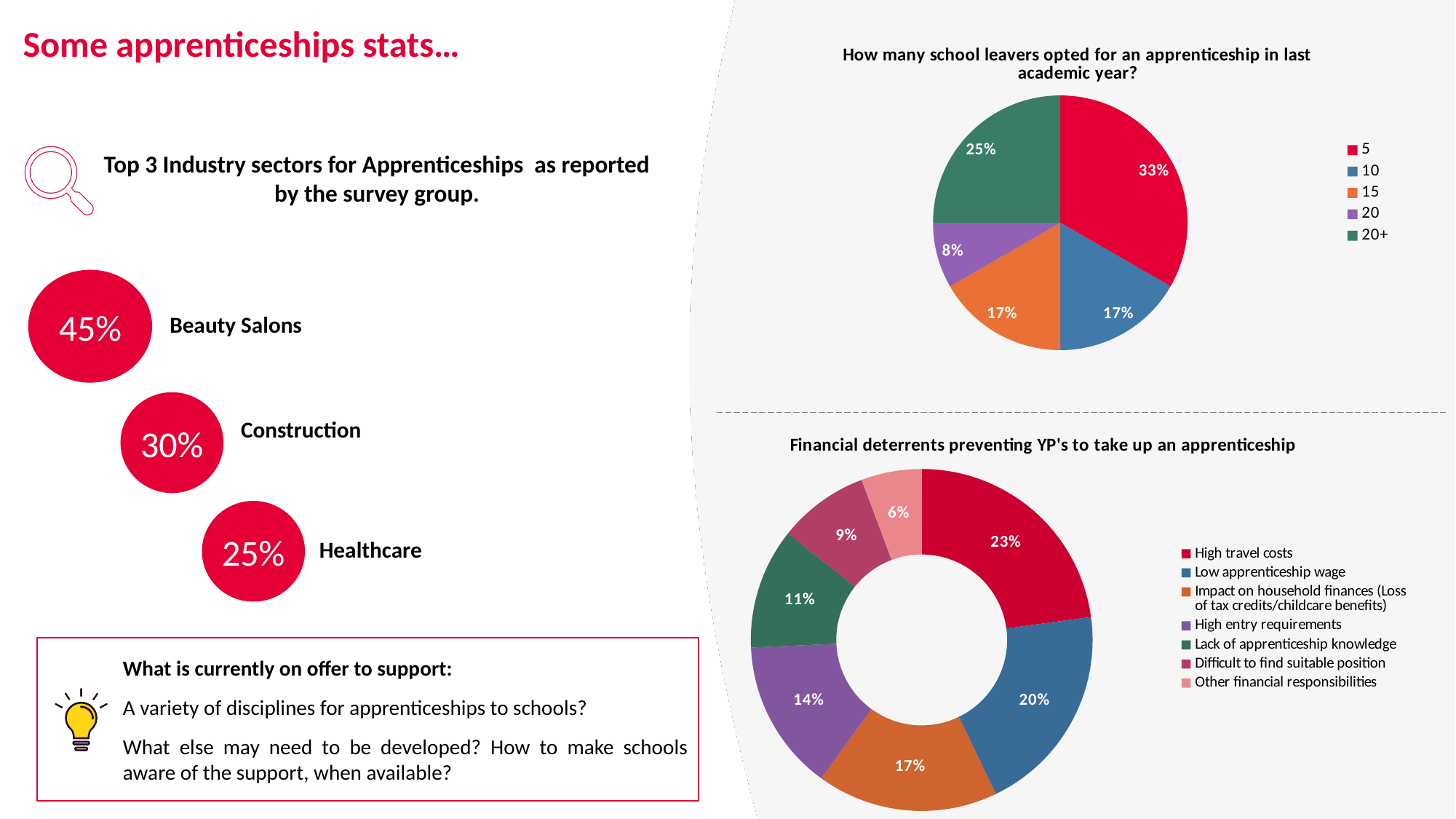
In the chart 'How many school leavers opted for an apprenticeship in last academic year?', what share of the pie is the '5' category? 33% In the chart 'How many school leavers opted for an apprenticeship in last academic year?', which category has the largest slice? 5 In the chart 'Financial deterrents preventing YP's to take up an apprenticeship', which is larger: 'Low apprenticeship wage' or 'High entry requirements'? Low apprenticeship wage In the chart 'How many school leavers opted for an apprenticeship in last academic year?', which category has the smallest slice? 20 How many categories does the legend list in the chart 'How many school leavers opted for an apprenticeship in last academic year?' 5 In the chart 'How many school leavers opted for an apprenticeship in last academic year?', what share of the pie is the '20+' category? 25% How many categories does the legend list in the chart 'Financial deterrents preventing YP's to take up an apprenticeship'? 7 In the chart 'How many school leavers opted for an apprenticeship in last academic year?', what is the difference in percentage points between the '5' slice and the '20' slice? 25 In the chart 'Financial deterrents preventing YP's to take up an apprenticeship', what share is 'Lack of apprenticeship knowledge'? 11% In the chart 'Financial deterrents preventing YP's to take up an apprenticeship', what share is 'High travel costs'? 23% What kind of chart is 'Financial deterrents preventing YP's to take up an apprenticeship'? Doughnut chart In the chart 'Financial deterrents preventing YP's to take up an apprenticeship', which deterrent has the smallest share? Other financial responsibilities